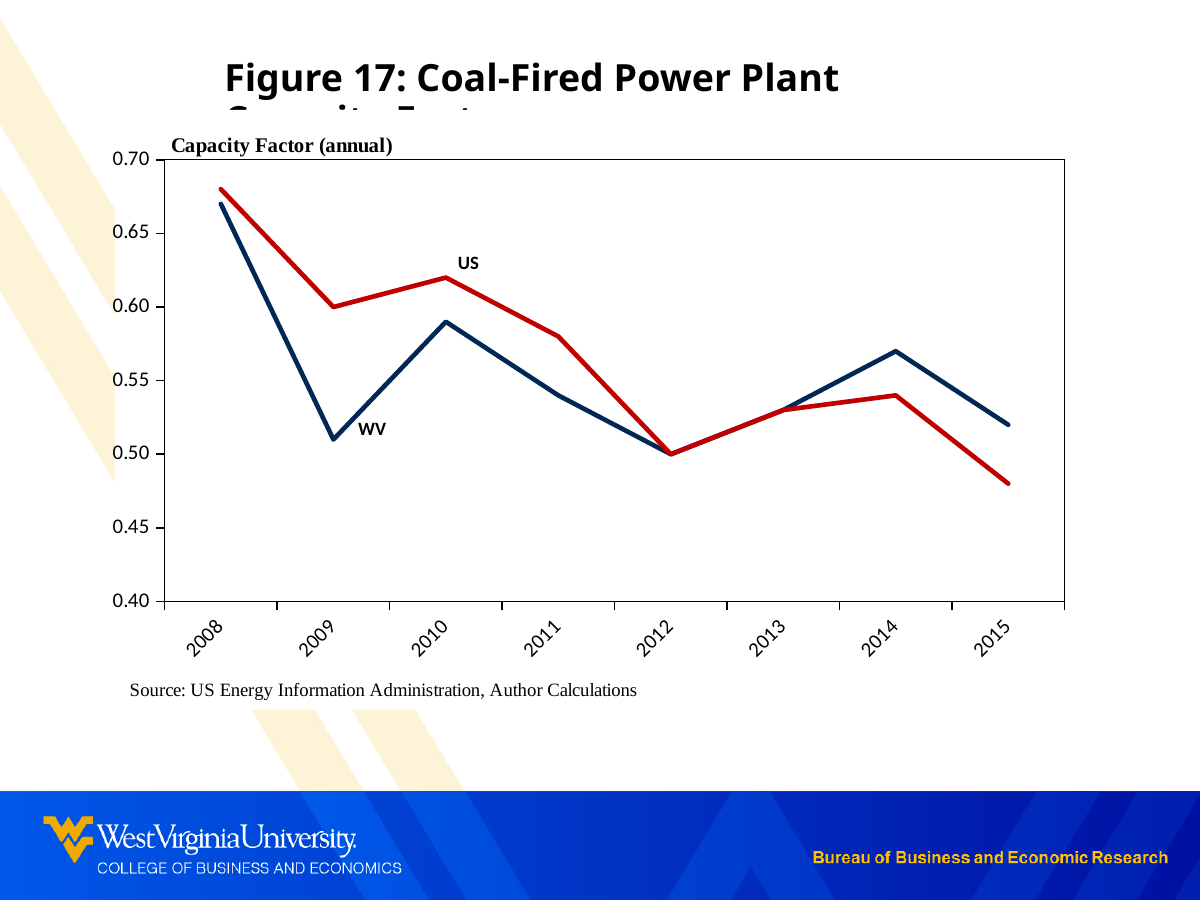
What is the US capacity factor in 2009? 0.60 How many years are shown on the x axis? 8 In 2010, which series has the higher capacity factor, US or WV? US In 2014, which series has the higher capacity factor, US or WV? WV In which year is the US capacity factor lowest? 2015 How many series are plotted on the chart? 2 In which year is the US capacity factor highest? 2008 Is the WV capacity factor in 2009 greater or less than 0.55? less What is the US capacity factor in 2012? 0.50 In which year is the WV capacity factor lowest? 2012 Is the US capacity factor in 2015 greater or less than 0.50? less What kind of chart is shown on the slide? line chart